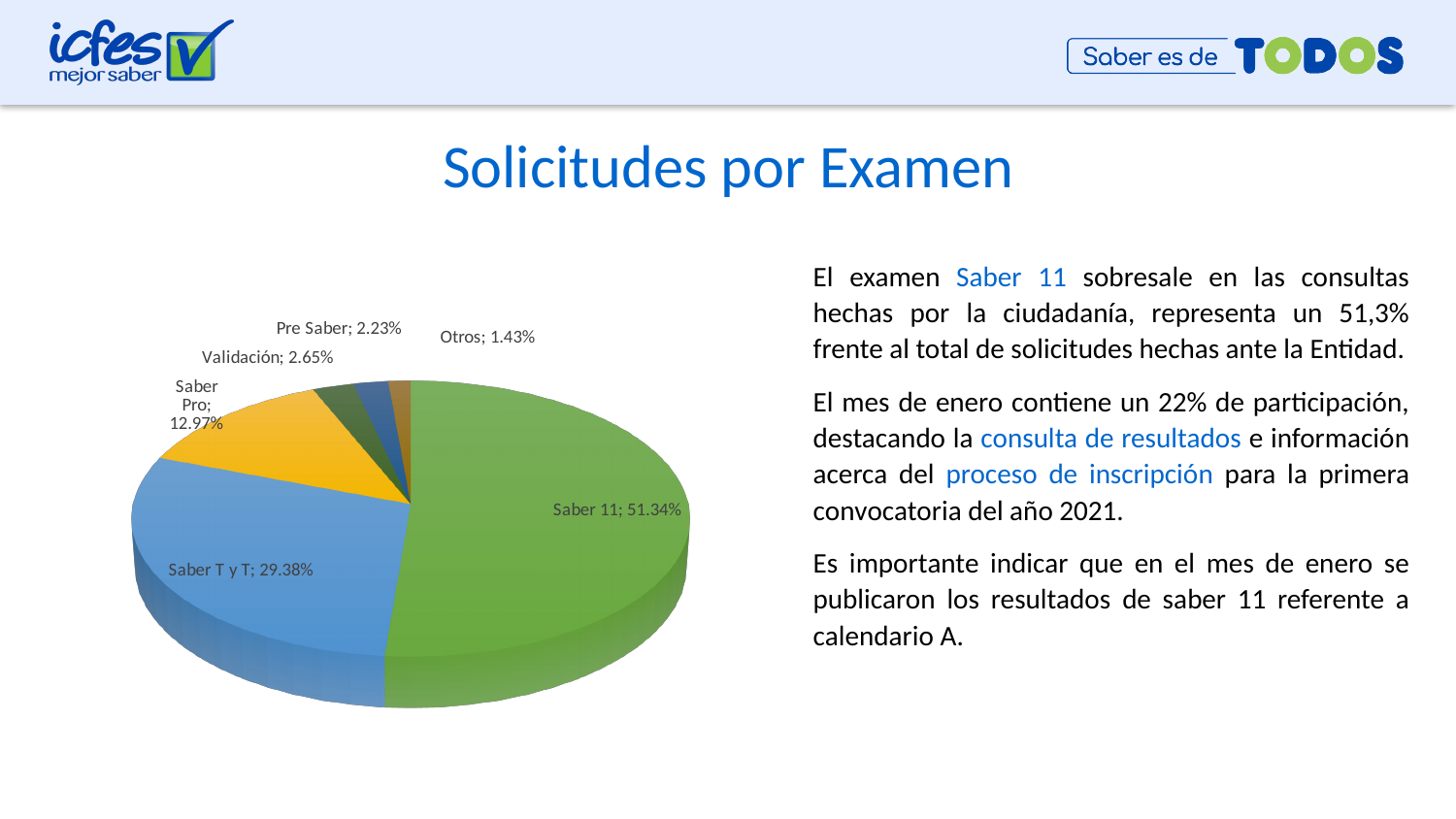
What is the difference in percentage points between Saber 11 and Saber T y T? 21.96 What share of the pie does Saber 11 represent? 51.34% Which is larger, the share for Validación or the share for Pre Saber? Validación What is the title of the slide containing the pie chart? Solicitudes por Examen What percentage is shown for Otros? 1.43% Which category has the largest slice of the pie? Saber 11 How many slices does the pie chart have? 6 What is the value shown for Saber T y T? 29.38% What is the value shown for Validación? 2.65% What percentage is shown for Saber Pro? 12.97% Which category has the smallest slice of the pie? Otros What kind of chart is shown on the slide? Pie chart